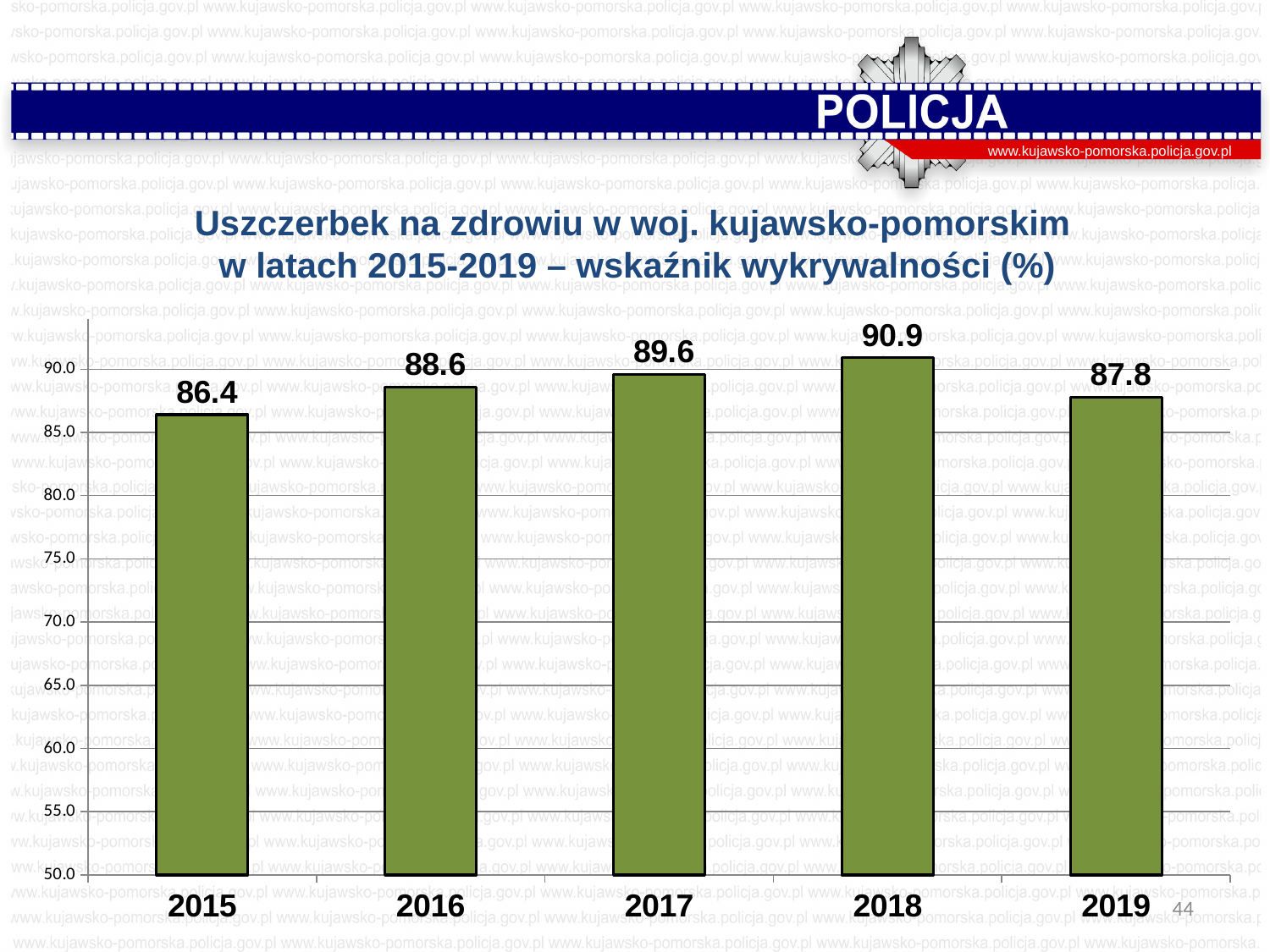
How many years are shown on the chart? 5 What is the value shown for 2019? 87.8 What type of chart is shown on the slide? bar chart What is the detection rate (wskaźnik wykrywalności) for 2015? 86.4 Is the value for 2017 greater or less than 85.0? greater What is the value shown for 2018? 90.9 Which year has the highest detection rate? 2018 Which is larger, the value for 2016 or the value for 2019? 2016 What is the difference between the values for 2018 and 2015? 4.5 Does the detection rate rise or fall from 2015 to 2018? rise Which year has the lowest detection rate? 2015 What is the difference between the values for 2017 and 2016? 1.0